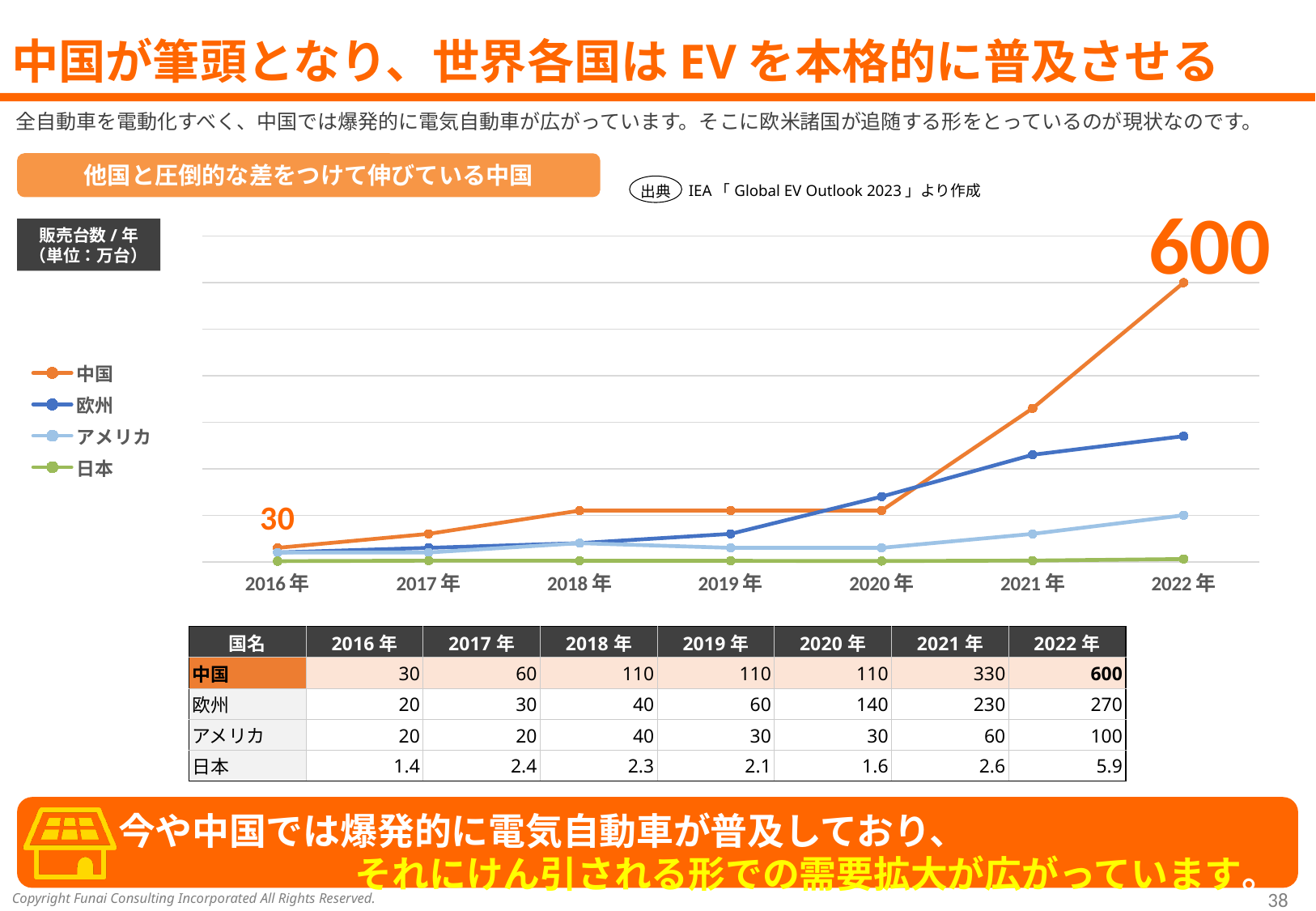
What is the value for 中国 in 2022年? 600 Does the 中国 series rise or fall from 2020年 to 2022年? rise Which series has the highest value in 2022年? 中国 In 2020年, which is larger: the value for 欧州 or the value for 中国? 欧州 How many years are plotted along the x axis of the chart? 7 What is the difference between the 中国 value in 2022年 and the 欧州 value in 2022年? 330 Which series has the lowest value in 2022年? 日本 What is the value for 日本 in 2022年? 5.9 What kind of chart is shown on the slide? line chart What is the value for 欧州 in 2020年? 140 What is the value for 中国 in 2016年? 30 How many series does the chart legend list? 4